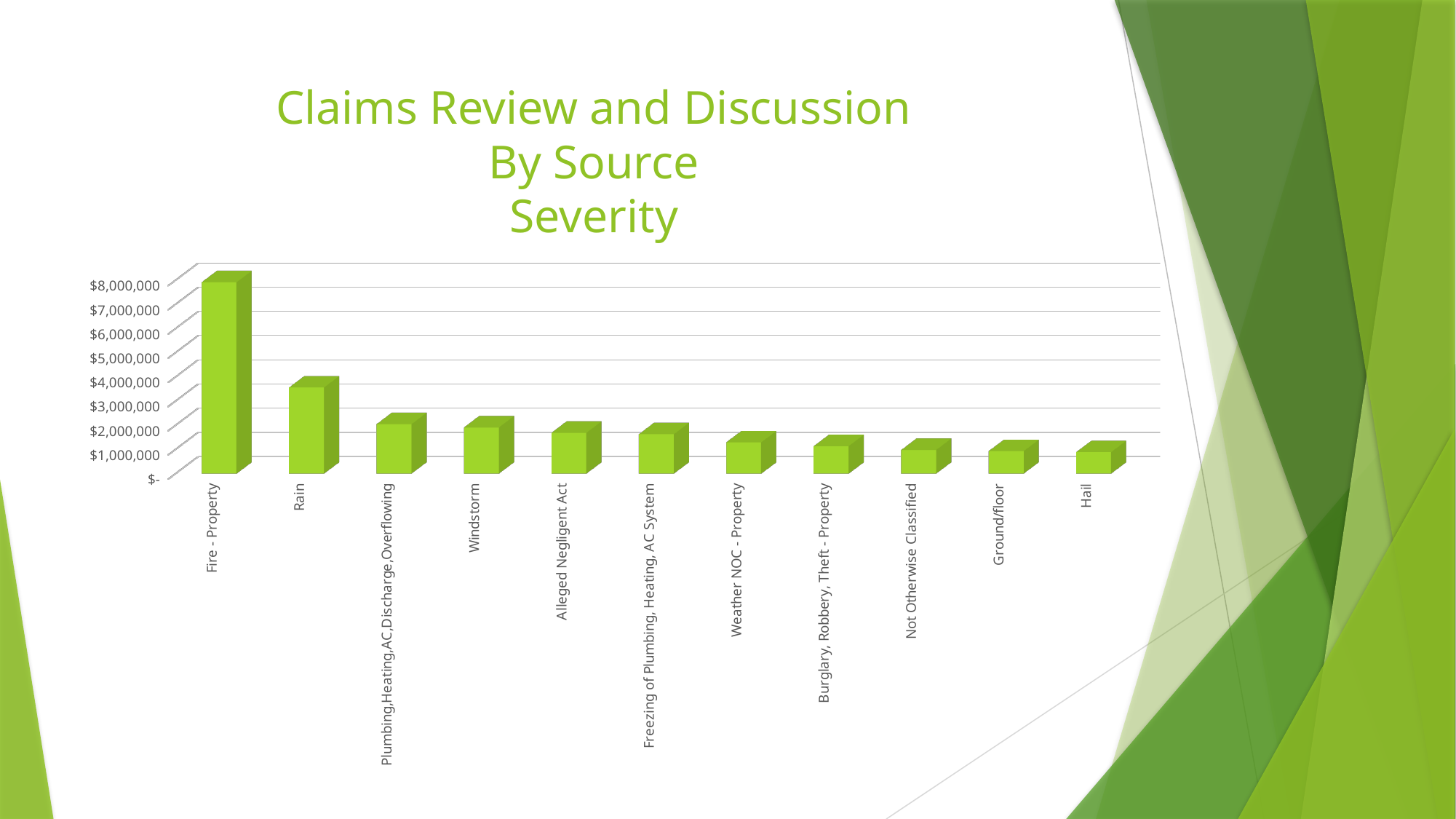
How many categories (claim sources) are plotted on the chart? 11 Is the value for Rain greater or less than $4,000,000? less Do the values rise or fall moving from left to right along the x axis? Fall Is the value for Hail greater or less than $2,000,000? less What is the title shown above the chart? Claims Review and Discussion By Source Severity Is the value for Weather NOC - Property greater or less than $2,000,000? less Which is larger, the value for Fire - Property or the value for Rain? Fire - Property Which is larger, the value for Windstorm or the value for Hail? Windstorm What kind of chart is shown on the slide? Bar chart Which claim source has the highest severity value? Fire - Property